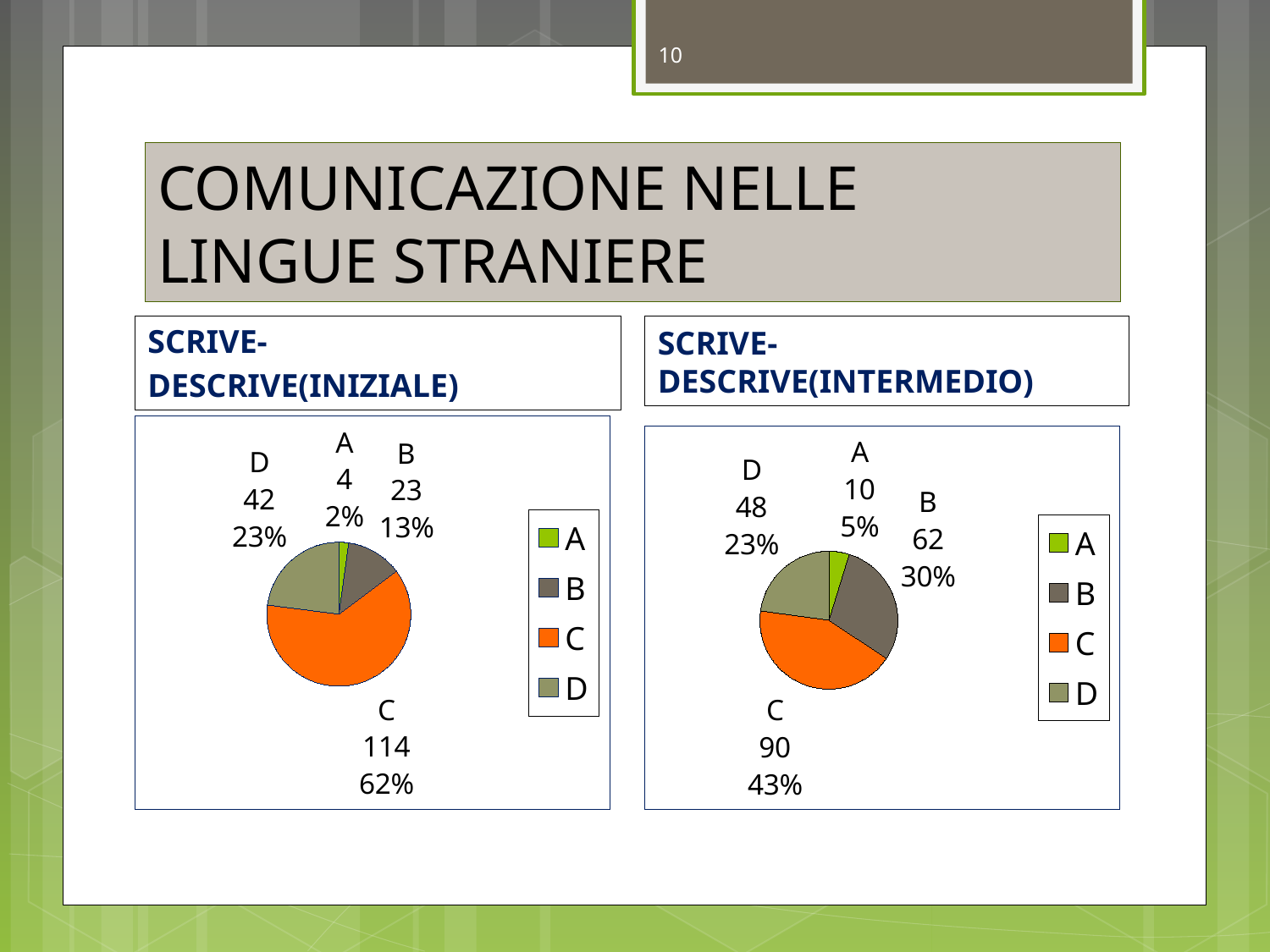
In the SCRIVE-DESCRIVE(INIZIALE) pie chart, which category has the largest value? C In the SCRIVE-DESCRIVE(INTERMEDIO) pie chart, what is the value for B? 62 In the SCRIVE-DESCRIVE(INTERMEDIO) pie chart, what percentage share does A have? 5% What kind of chart is used for SCRIVE-DESCRIVE(INTERMEDIO)? Pie chart In the SCRIVE-DESCRIVE(INTERMEDIO) pie chart, which category has the smallest value? A In the SCRIVE-DESCRIVE(INIZIALE) pie chart, what is the value for C? 114 How many categories does the SCRIVE-DESCRIVE(INIZIALE) pie chart show? 4 In the SCRIVE-DESCRIVE(INIZIALE) chart, what colour is the slice for C in the legend? Orange In the SCRIVE-DESCRIVE(INTERMEDIO) pie chart, which is larger, the value for C or the value for B? C In the SCRIVE-DESCRIVE(INIZIALE) pie chart, what is the difference between the values for C and D? 72 In the SCRIVE-DESCRIVE(INTERMEDIO) pie chart, what is the difference between the values for B and D? 14 In the SCRIVE-DESCRIVE(INIZIALE) pie chart, what percentage share does D have? 23%